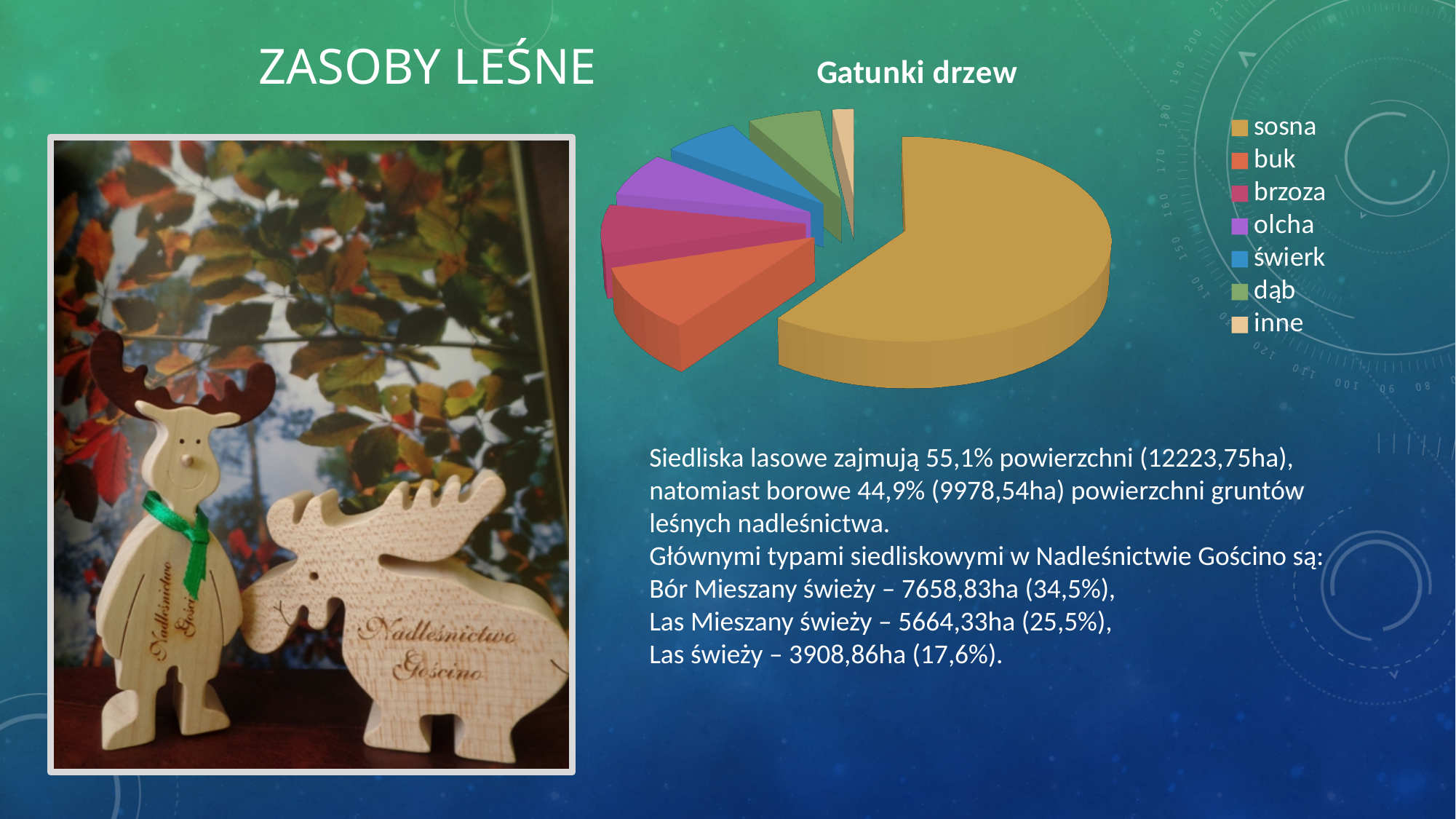
In the "Gatunki drzew" pie chart, which slice is larger: buk or brzoza? buk Which tree species is listed second in the legend of the "Gatunki drzew" chart? buk What kind of chart is shown under the title "Gatunki drzew"? pie chart Which tree species has the smallest slice in the "Gatunki drzew" pie chart? inne In the "Gatunki drzew" pie chart, which slice is larger: dąb or inne? dąb How many categories (slices) does the pie chart "Gatunki drzew" have? 7 Which legend entry in the "Gatunki drzew" chart is shown in orange-red? buk In the "Gatunki drzew" pie chart, which slice is larger: sosna or buk? sosna What is the title of the chart on the slide? Gatunki drzew Which tree species has the largest slice in the "Gatunki drzew" pie chart? sosna